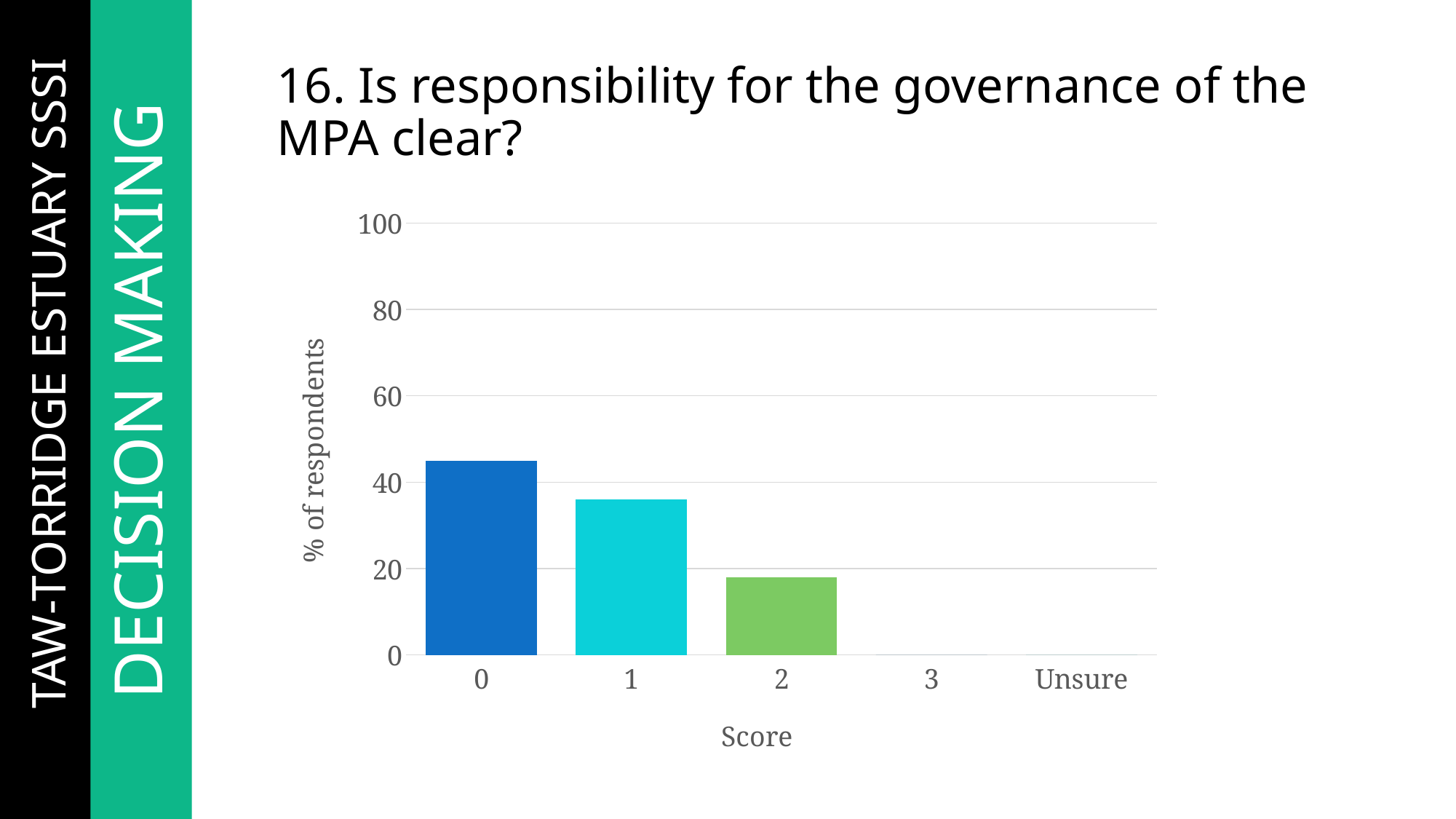
Which score has the highest percentage of respondents? 0 What is the percentage of respondents for Unsure? 0 Do the values rise or fall as the score increases from 0 to 3? fall How many score categories are shown on the x axis? 5 Which is larger, the value for score 0 or the value for score 1? score 0 What is the label on the y axis? % of respondents Is the value for score 2 greater or less than 20? less What kind of chart is shown on the slide? bar chart What is the label on the x axis? Score Is the value for score 0 greater or less than 40? greater What is the percentage of respondents for score 3? 0 Is the value for score 1 greater or less than 40? less